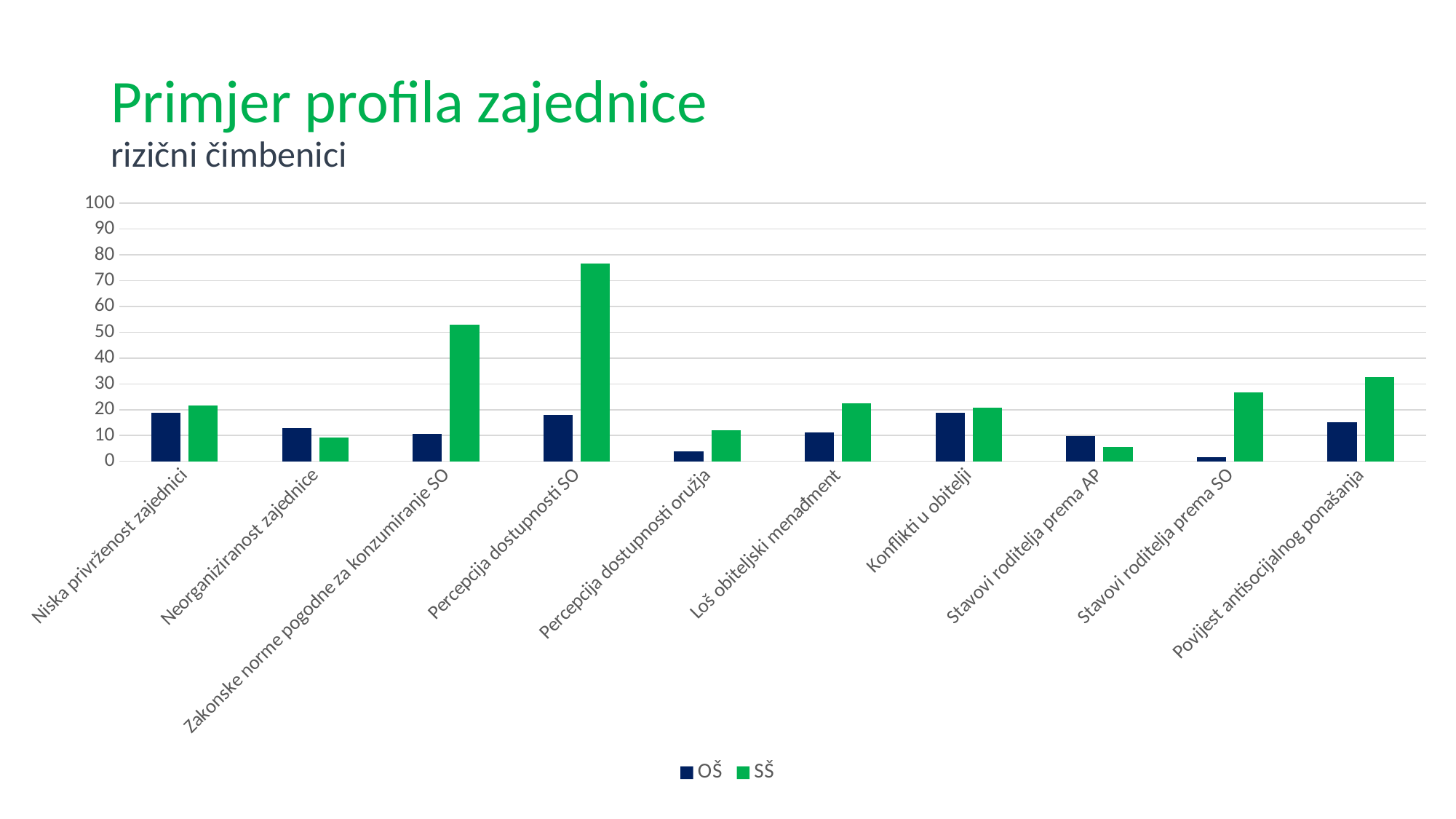
How many series does the legend list? 2 For Neorganiziranost zajednice, which series has the larger value, OŠ or SŠ? OŠ What kind of chart is shown on the slide? bar chart Is the OŠ value for Percepcija dostupnosti oružja greater or less than 10? less For Povijest antisocijalnog ponašanja, which series has the larger value, OŠ or SŠ? SŠ Is the SŠ value for Percepcija dostupnosti SO greater or less than 70? greater How many categories are shown on the x axis of the chart? 10 What is the subtitle shown under the slide title? rizični čimbenici Which category has the lowest OŠ value? Stavovi roditelja prema SO Which category has the highest SŠ value? Percepcija dostupnosti SO Which category has the lowest SŠ value? Stavovi roditelja prema AP Is the SŠ value for Zakonske norme pogodne za konzumiranje SO greater or less than 50? greater